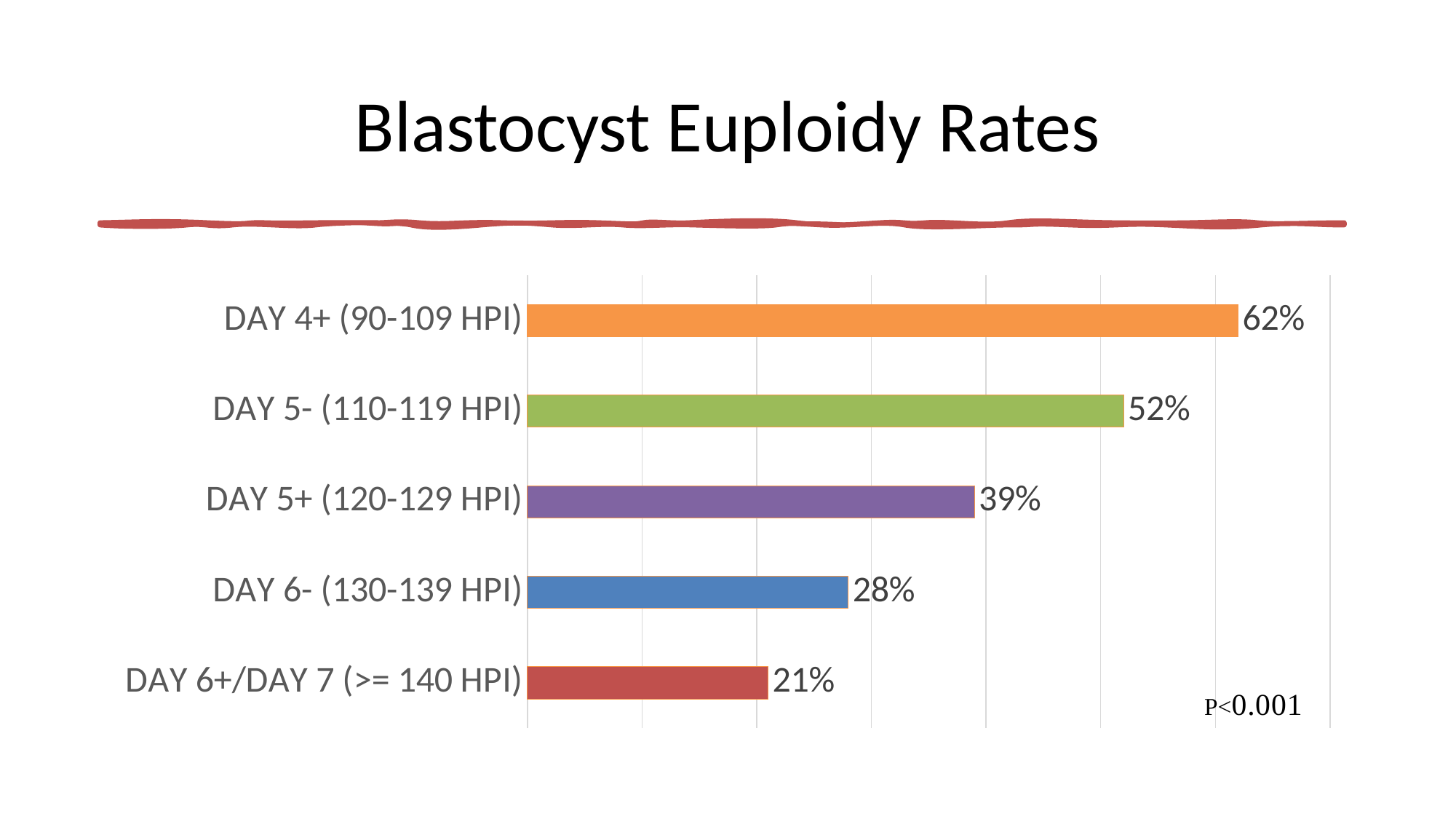
What is the difference in euploidy rate between DAY 4+ (90-109 HPI) and DAY 5- (110-119 HPI)? 10% What is the difference in euploidy rate between DAY 5+ (120-129 HPI) and DAY 6- (130-139 HPI)? 11% Which category has the highest blastocyst euploidy rate? DAY 4+ (90-109 HPI) What is the blastocyst euploidy rate for DAY 6+/DAY 7 (>= 140 HPI)? 21% Which has a higher euploidy rate, DAY 5+ (120-129 HPI) or DAY 6- (130-139 HPI)? DAY 5+ (120-129 HPI) What kind of chart is shown on the slide? Bar chart Do the euploidy rates rise or fall as the categories move from DAY 4+ down to DAY 6+/DAY 7? Fall How many categories are shown in the chart? 5 What is the blastocyst euploidy rate for DAY 4+ (90-109 HPI)? 62% What p-value is noted on the chart? P<0.001 Which category has the lowest blastocyst euploidy rate? DAY 6+/DAY 7 (>= 140 HPI) What is the blastocyst euploidy rate for DAY 5- (110-119 HPI)? 52%